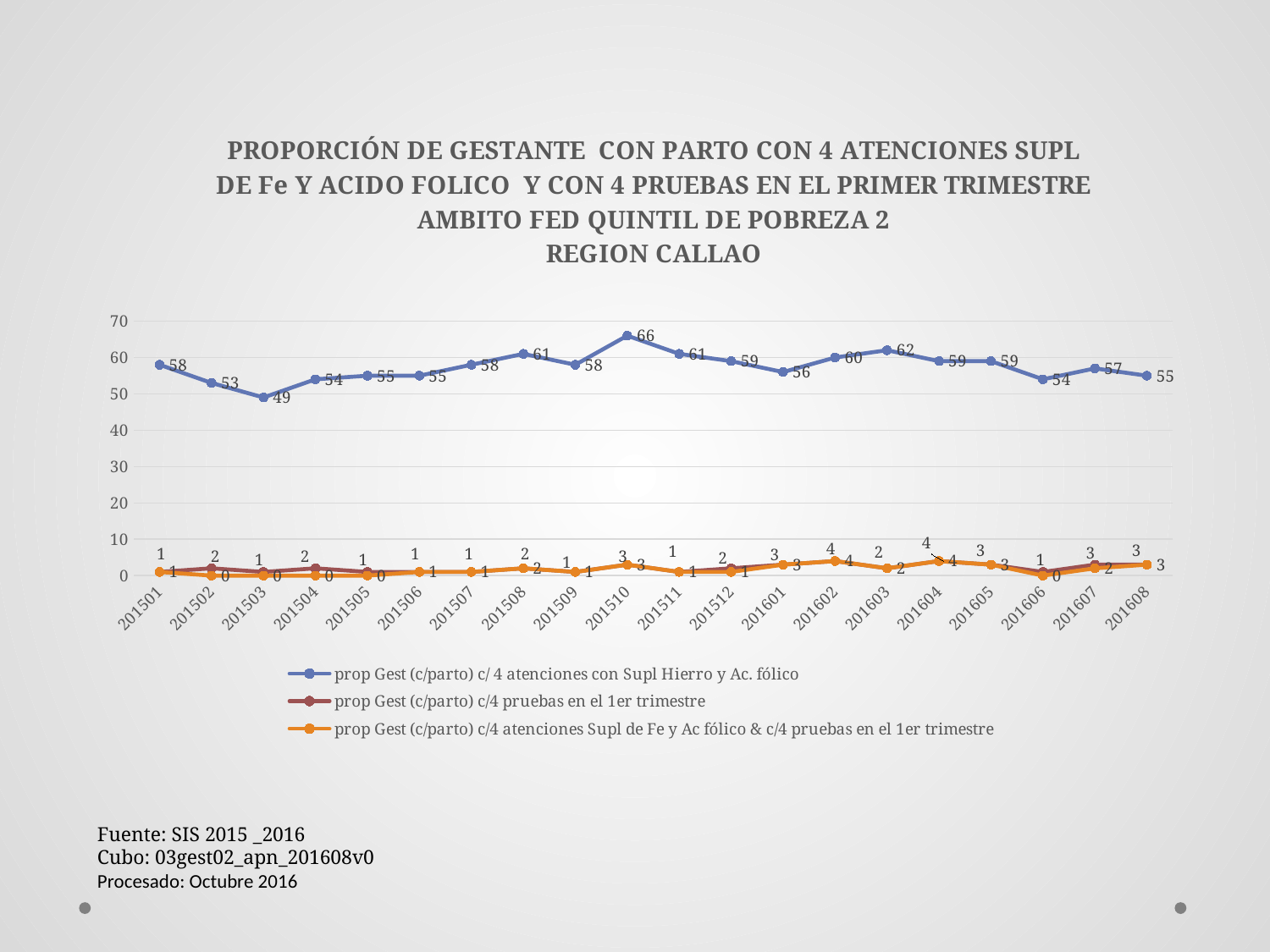
Which period has the larger value for 'prop Gest (c/parto) c/ 4 atenciones con Supl Hierro y Ac. fólico', 201508 or 201603? 201603 What is the value of 'prop Gest (c/parto) c/ 4 atenciones con Supl Hierro y Ac. fólico' for 201601? 56 What kind of chart is shown on the slide? line chart In which period does 'prop Gest (c/parto) c/ 4 atenciones con Supl Hierro y Ac. fólico' reach its highest value? 201510 Does 'prop Gest (c/parto) c/ 4 atenciones con Supl Hierro y Ac. fólico' rise or fall from 201501 to 201503? fall In which period does 'prop Gest (c/parto) c/ 4 atenciones con Supl Hierro y Ac. fólico' reach its lowest value? 201503 Which region does the chart title say the data is for? REGION CALLAO How many time periods are plotted along the x axis? 20 What is the value of 'prop Gest (c/parto) c/ 4 atenciones con Supl Hierro y Ac. fólico' for 201503? 49 How many series does the legend list? 3 What is the value of 'prop Gest (c/parto) c/4 atenciones Supl de Fe y Ac fólico & c/4 pruebas en el 1er trimestre' for 201502? 0 What is the difference between the highest and lowest values of 'prop Gest (c/parto) c/ 4 atenciones con Supl Hierro y Ac. fólico'? 17